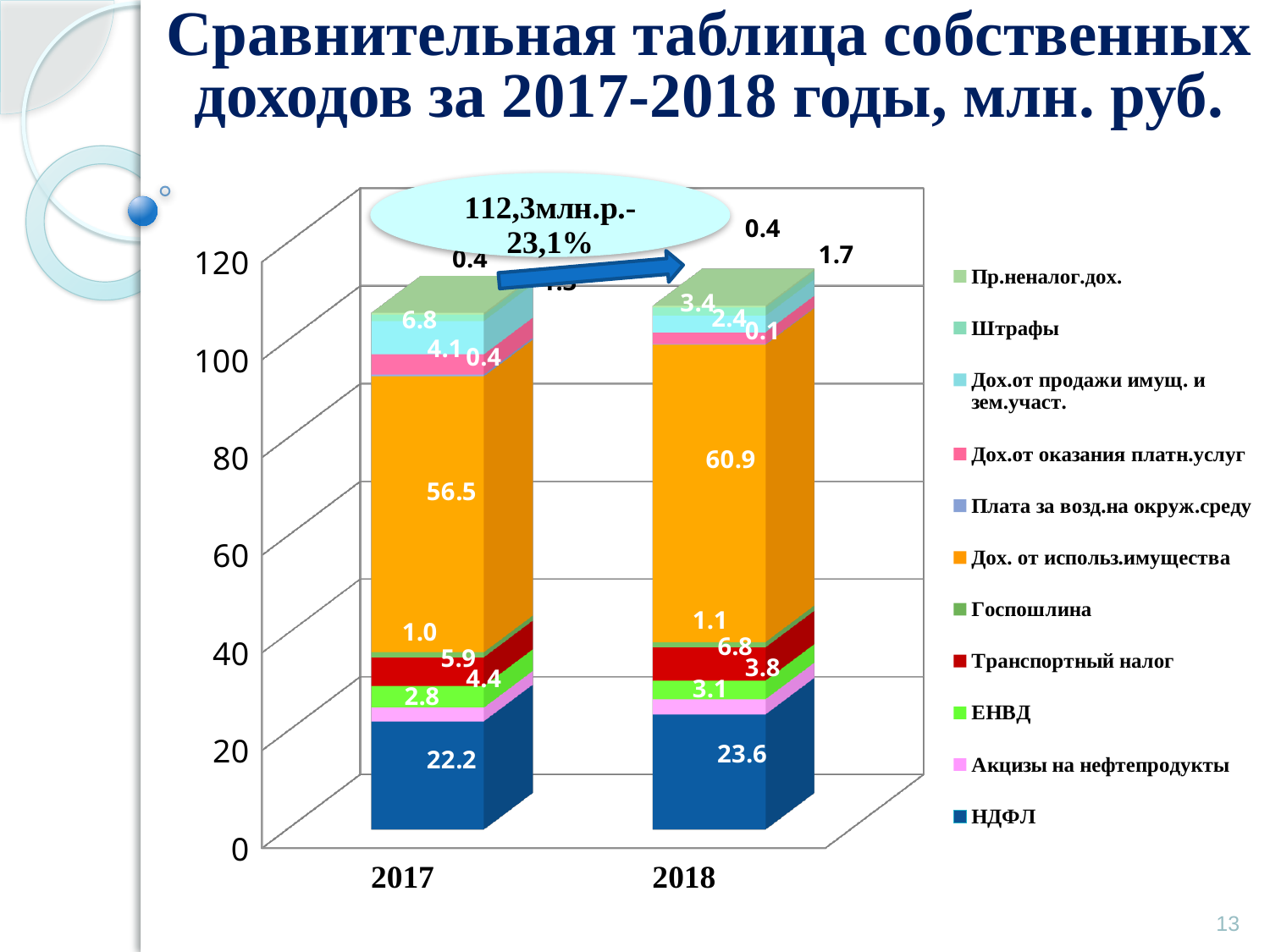
Which series forms the largest segment of the 2018 bar? Дох. от использ.имущества What is the value of НДФЛ for 2017? 22.2 What is the value of НДФЛ for 2018? 23.6 What is the value of Дох. от использ.имущества for 2018? 60.9 What is the value of Транспортный налог for 2017? 5.9 What type of chart is shown on the slide? stacked bar chart How many years (categories) are shown on the x axis? 2 By how much did Дох. от использ.имущества change from 2017 (56.5) to 2018 (60.9)? 4.4 Which year has the larger НДФЛ value, 2017 or 2018? 2018 What is the value of ЕНВД for 2018? 3.8 How many series does the legend list? 11 Is the total height of the 2017 bar greater or less than 100? greater